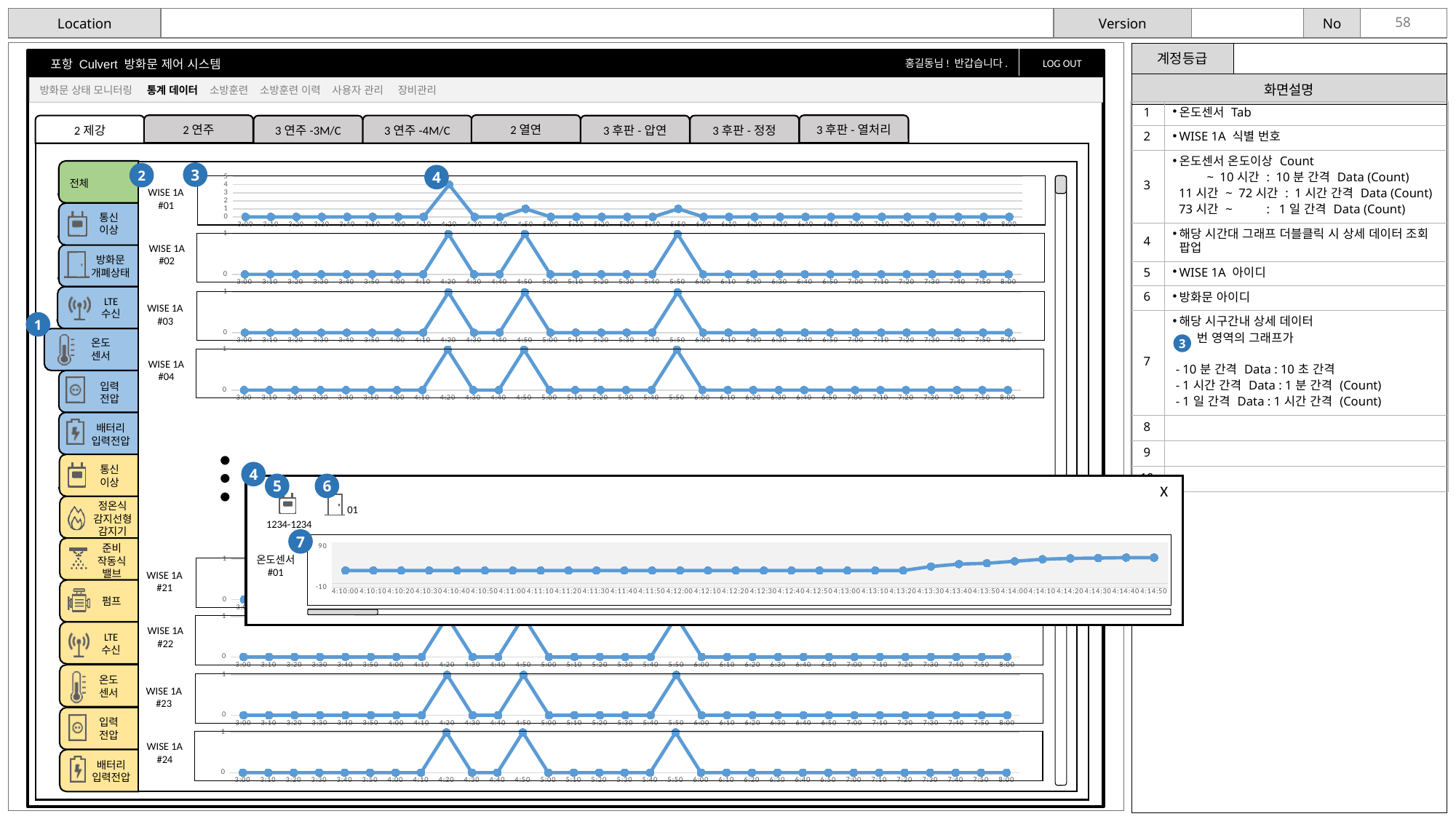
In the WISE 1A #23 chart, is the value at 6:00 greater or less than 1? less In the WISE 1A #01 chart, at which time does the line reach its highest value? 4:20 What kind of chart is used for the WISE 1A #01 panel? line chart In the WISE 1A #01 chart, is the value at 4:20 greater or less than 3? greater What is the last time label on the x axis of the WISE 1A #24 chart? 8:00 In the popup chart labelled 온도센서 #01, does the line rise or fall toward the right end of the x axis? rise In the WISE 1A #03 chart, which is larger, the value at 4:50 or the value at 5:00? 4:50 In the WISE 1A #02 chart, what is the value at 4:20? 1 What is the top y-axis label on the popup chart labelled 온도센서 #01? 90 In the WISE 1A #02 chart, what is the value at 3:00? 0 What is the first time label on the x axis of the WISE 1A #04 chart? 3:00 What is the highest y-axis tick shown on the WISE 1A #01 chart? 5